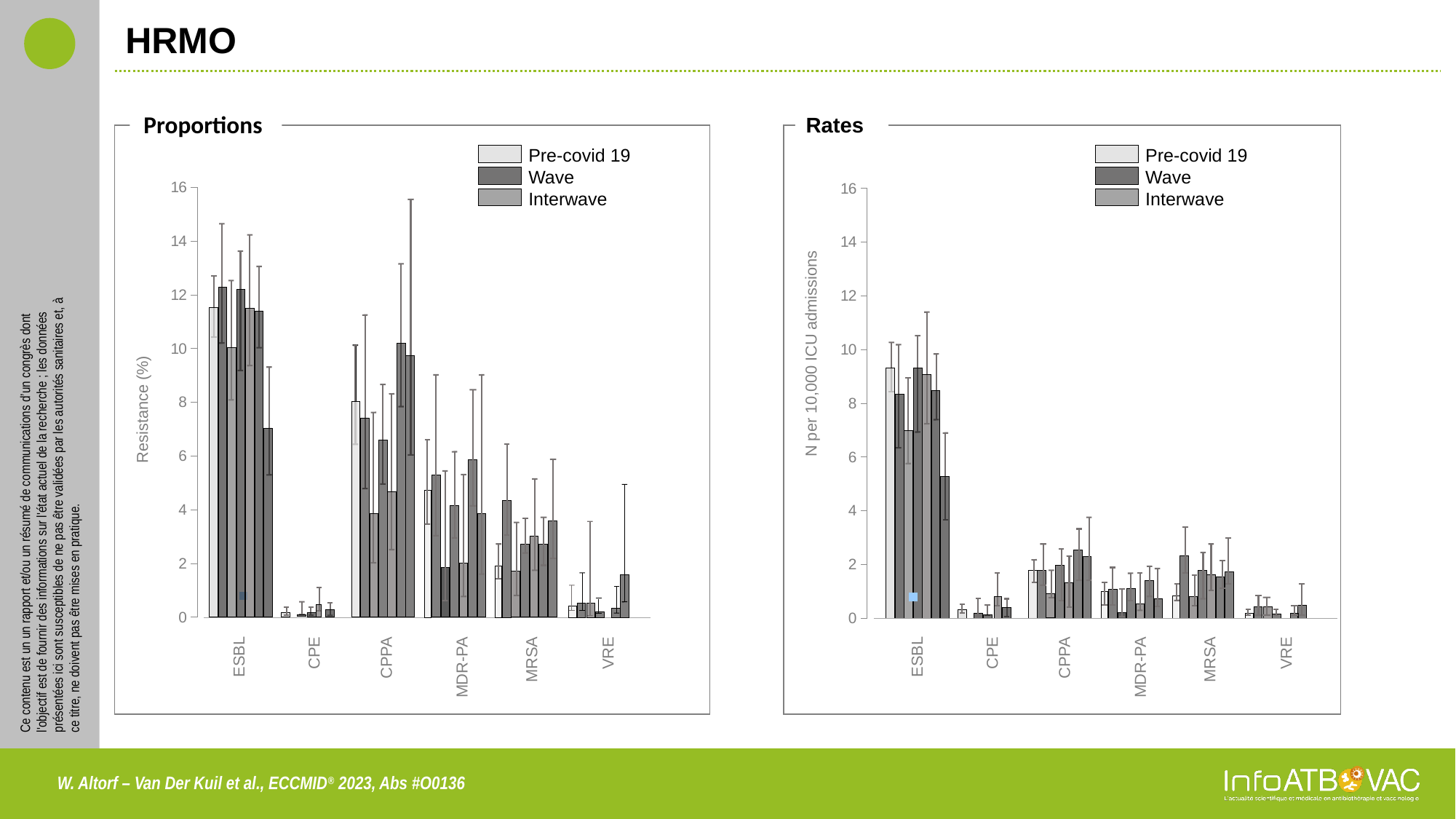
In the Rates chart, which category has the tallest bars? ESBL In the Rates chart, are the bars for VRE greater or less than 2? less In the Proportions chart, are the bars for CPE greater or less than 2? less What is the y-axis label of the Rates chart? N per 10,000 ICU admissions How many series does the legend of the Proportions chart list? 3 How many categories are shown on the x axis of the Rates chart? 6 In the Rates chart, which has higher values, ESBL or MRSA? ESBL In the Proportions chart, is the first Pre-covid 19 bar for ESBL greater or less than 10? greater What kind of chart is the Proportions chart? bar chart In the Proportions chart, which category has the lowest bars? CPE In the Proportions chart, which category has the tallest bars? ESBL